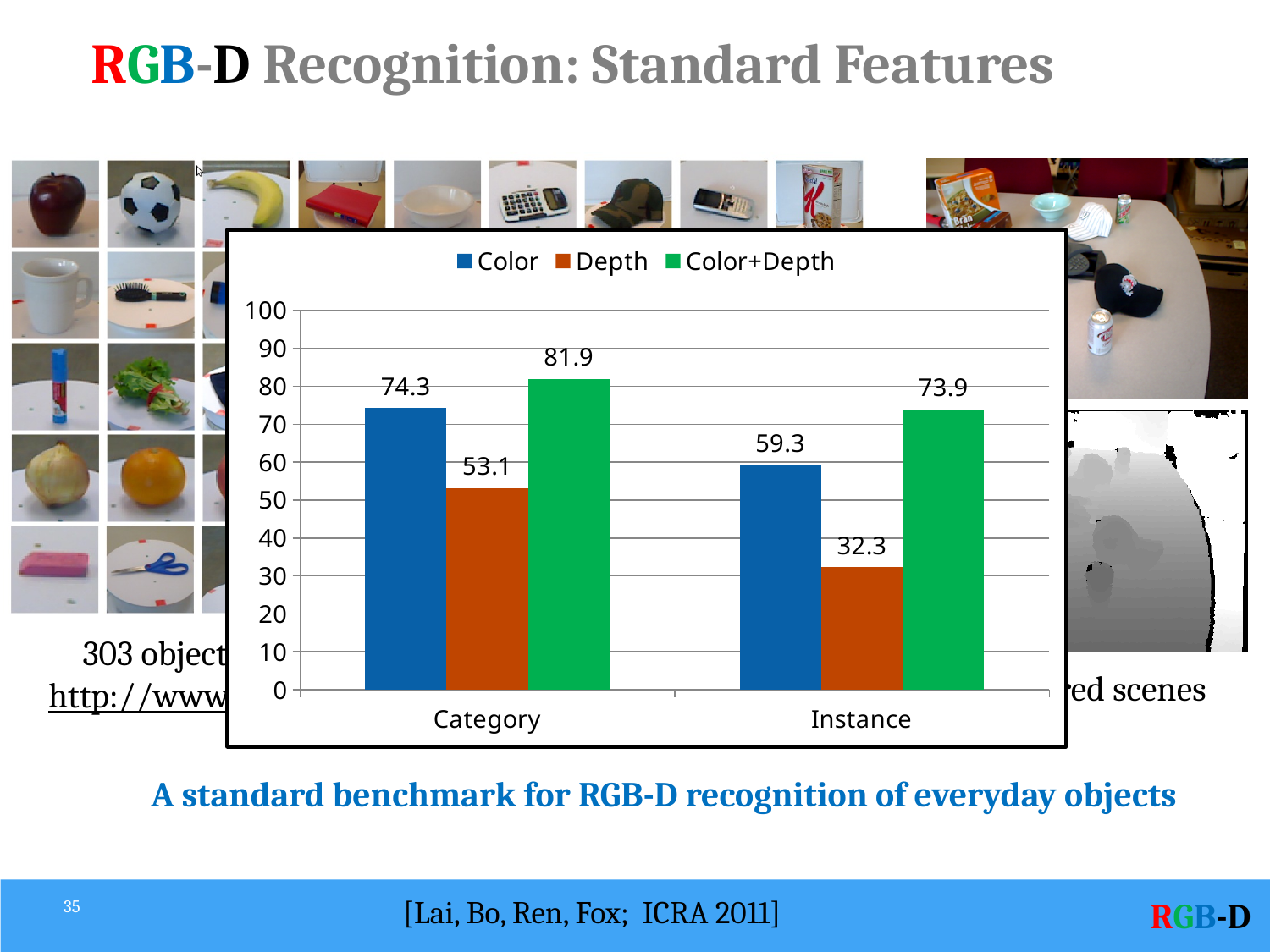
What is the Color value for Category? 74.3 How many series does the legend list? 3 What is the difference between the Color+Depth and Color values for Category? 7.6 How many categories are shown on the x axis? 2 Which series has the highest value for Instance? Color+Depth What is the difference between the Depth values for Category and Instance? 20.8 What is the Color+Depth value for Category? 81.9 What is the Color value for Instance? 59.3 What kind of chart is shown? bar chart Which is larger, the Color value for Category or the Color+Depth value for Instance? Color value for Category What is the Depth value for Instance? 32.3 Which series has the lowest value for Category? Depth